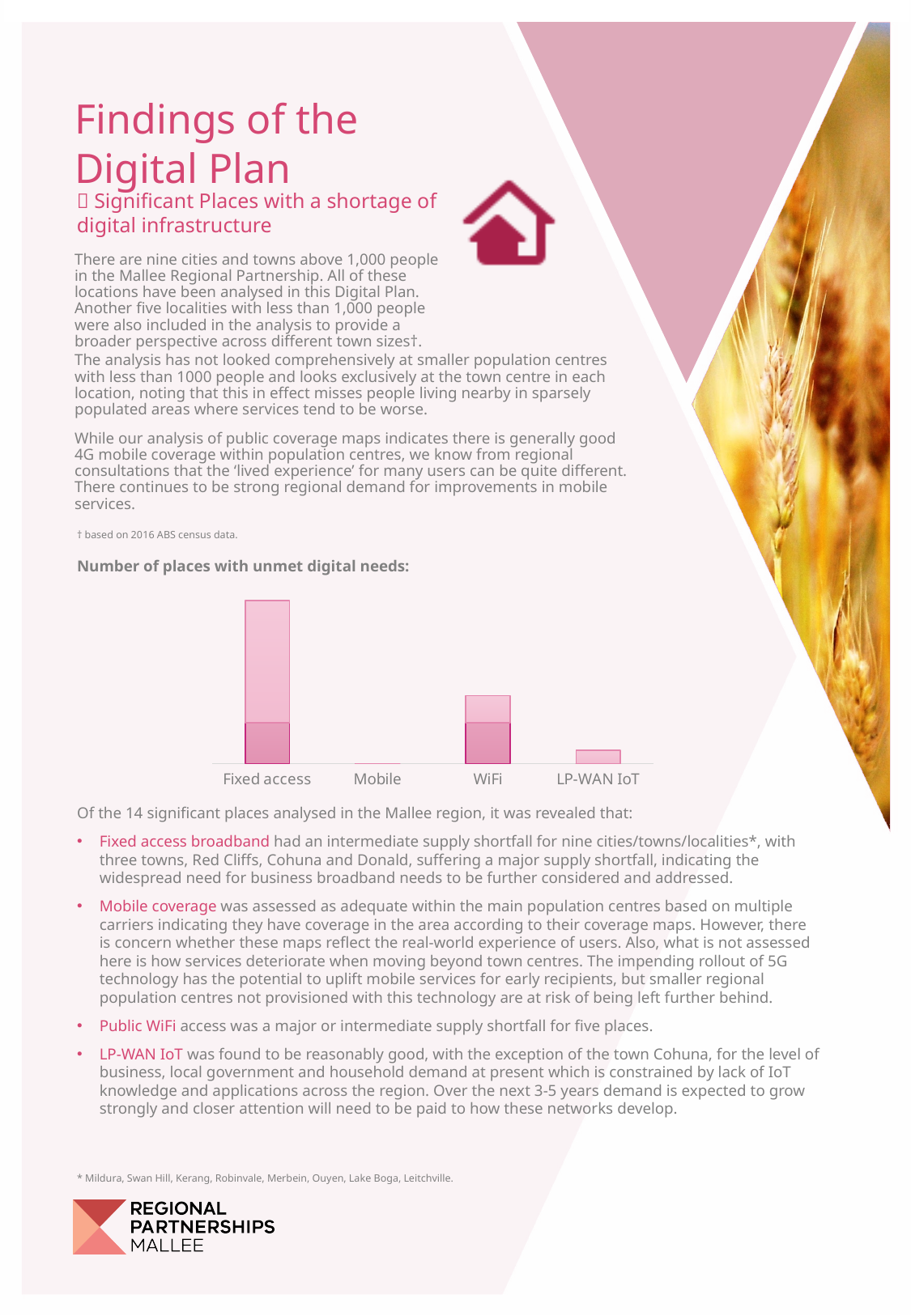
Which has the taller bar, Fixed access or WiFi? Fixed access What is the label of the second category from the left on the x axis? Mobile What is the title of the chart? Number of places with unmet digital needs: Which has the taller bar, Mobile or LP-WAN IoT? LP-WAN IoT Which has the taller bar, WiFi or LP-WAN IoT? WiFi Which category has the lowest value in the chart? Mobile How many categories are shown on the x axis of the chart? 4 What kind of chart is shown under 'Number of places with unmet digital needs'? Bar chart Which category has the tallest bar in the chart? Fixed access